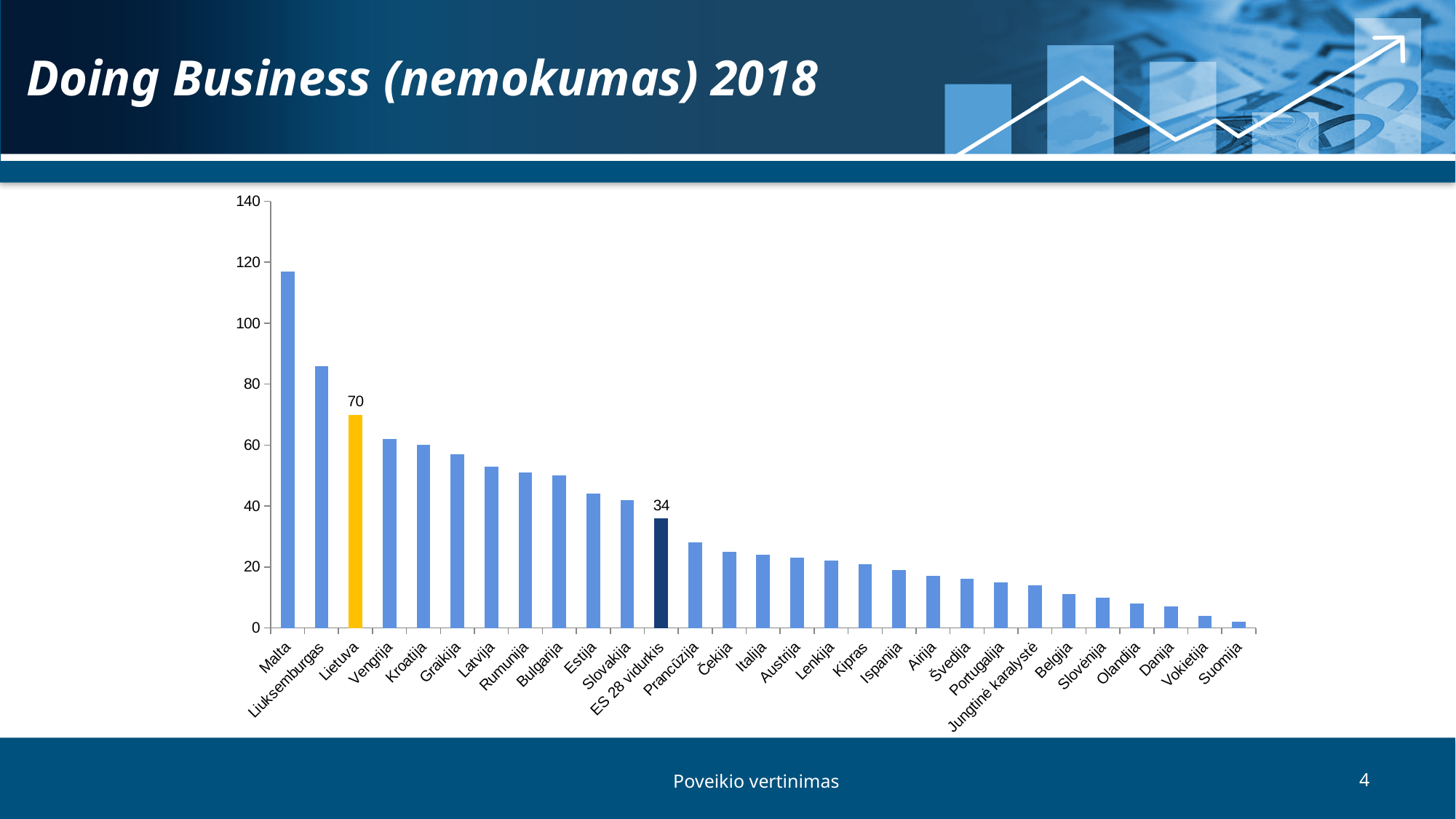
Do the values rise or fall from left to right along the x axis? fall Is the value for Malta greater or less than 100? greater Which is larger, the value for Malta or the value for Liuksemburgas? Malta Is the value for Liuksemburgas greater or less than 80? greater How many categories are shown on the x axis? 29 What is the value for ES 28 vidurkis? 34 Is the value for Suomija greater or less than 20? less What is the value for Lietuva? 70 What is the difference between the values for Lietuva and ES 28 vidurkis? 36 Which category has the lowest value? Suomija Which category has the highest value? Malta What kind of chart is shown on the slide? bar chart